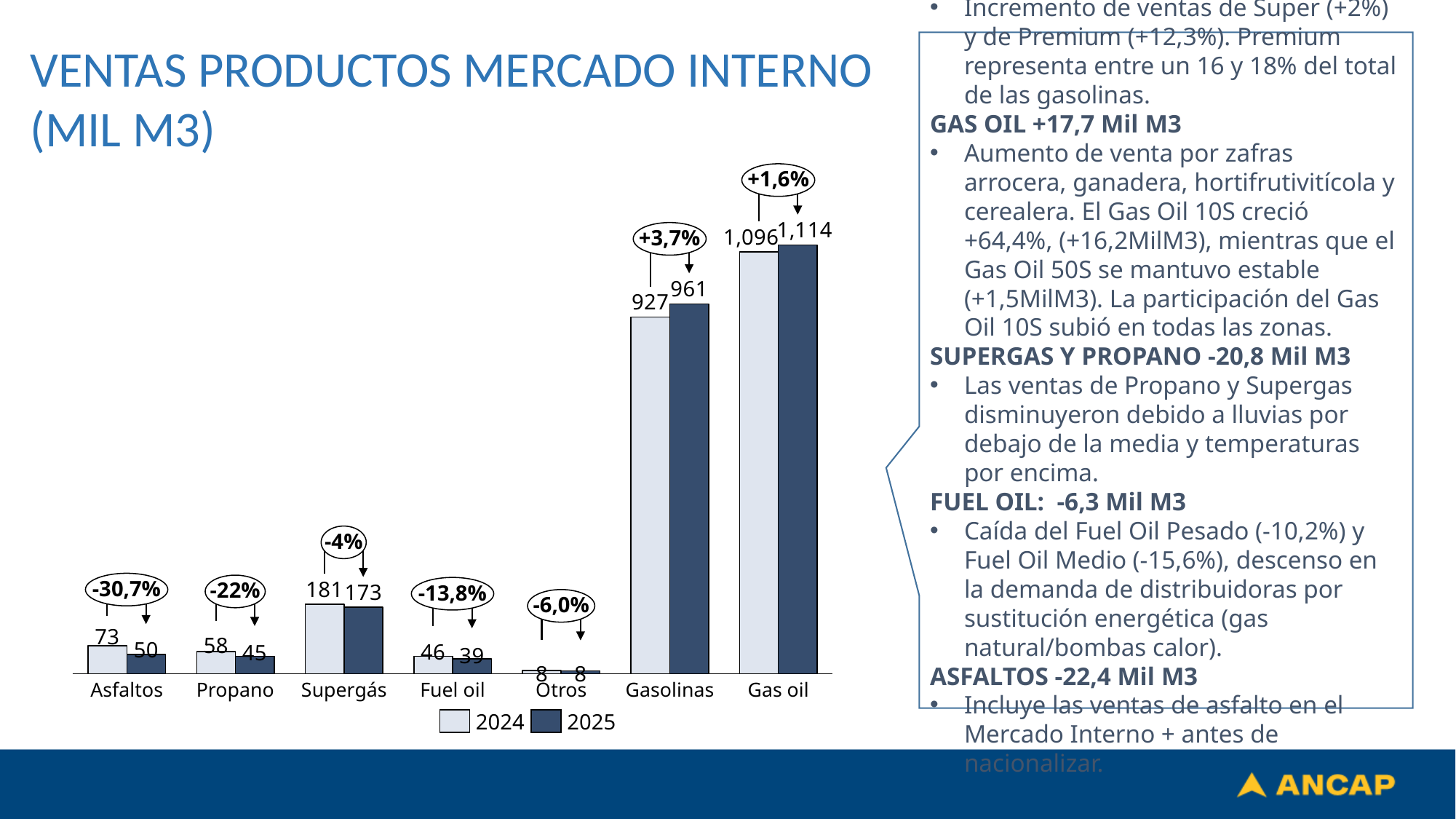
What is the difference between the 2024 and 2025 values for Asfaltos? 23 What kind of chart is shown on the slide? bar chart What is the 2025 value for Gasolinas? 961 What is the 2024 value for Supergás? 181 What is the 2025 value for Gas oil? 1,114 What is the title of the chart on the slide? VENTAS PRODUCTOS MERCADO INTERNO (MIL M3) Which category has the highest 2025 value? Gas oil How many product categories are shown on the x axis? 7 Which is larger for Fuel oil, the 2024 value or the 2025 value? 2024 How many series does the legend list? 2 What percentage change is annotated above the Propano bars? -22% Which category has the lowest 2024 value? Otros